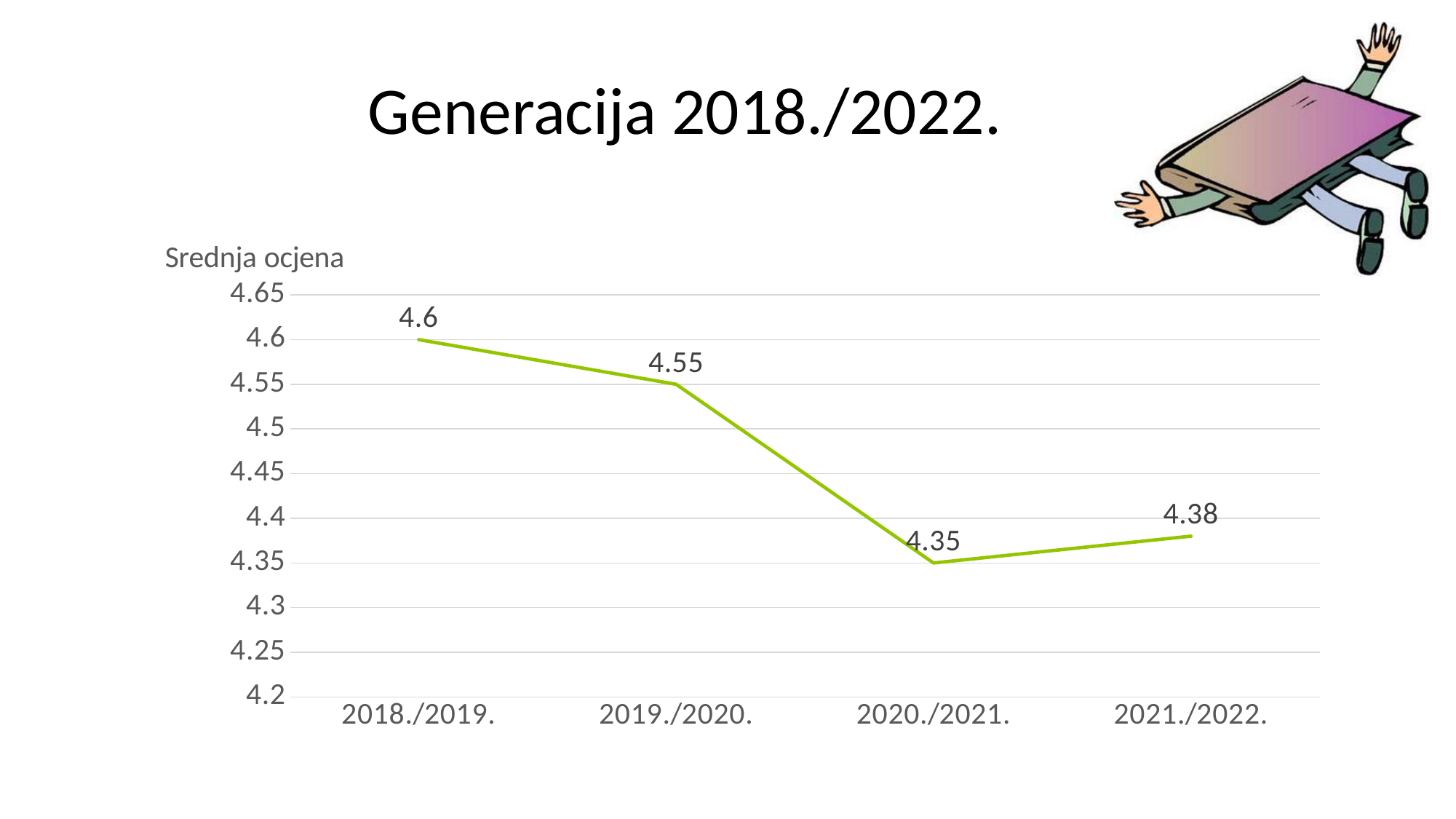
Which school year has the highest average grade? 2018./2019. What is the average grade for 2020./2021.? 4.35 What kind of chart is shown on the slide? Line chart What is the average grade (Srednja ocjena) for 2018./2019.? 4.6 Which is larger, the average grade for 2019./2020. or for 2021./2022.? 2019./2020. What is the title of the slide? Generacija 2018./2022. How many school years are plotted on the chart? 4 What is the average grade for 2019./2020.? 4.55 What is the difference between the average grade in 2018./2019. and in 2020./2021.? 0.25 Does the average grade rise or fall from 2018./2019. to 2020./2021.? Fall Which school year has the lowest average grade? 2020./2021. What is the average grade for 2021./2022.? 4.38